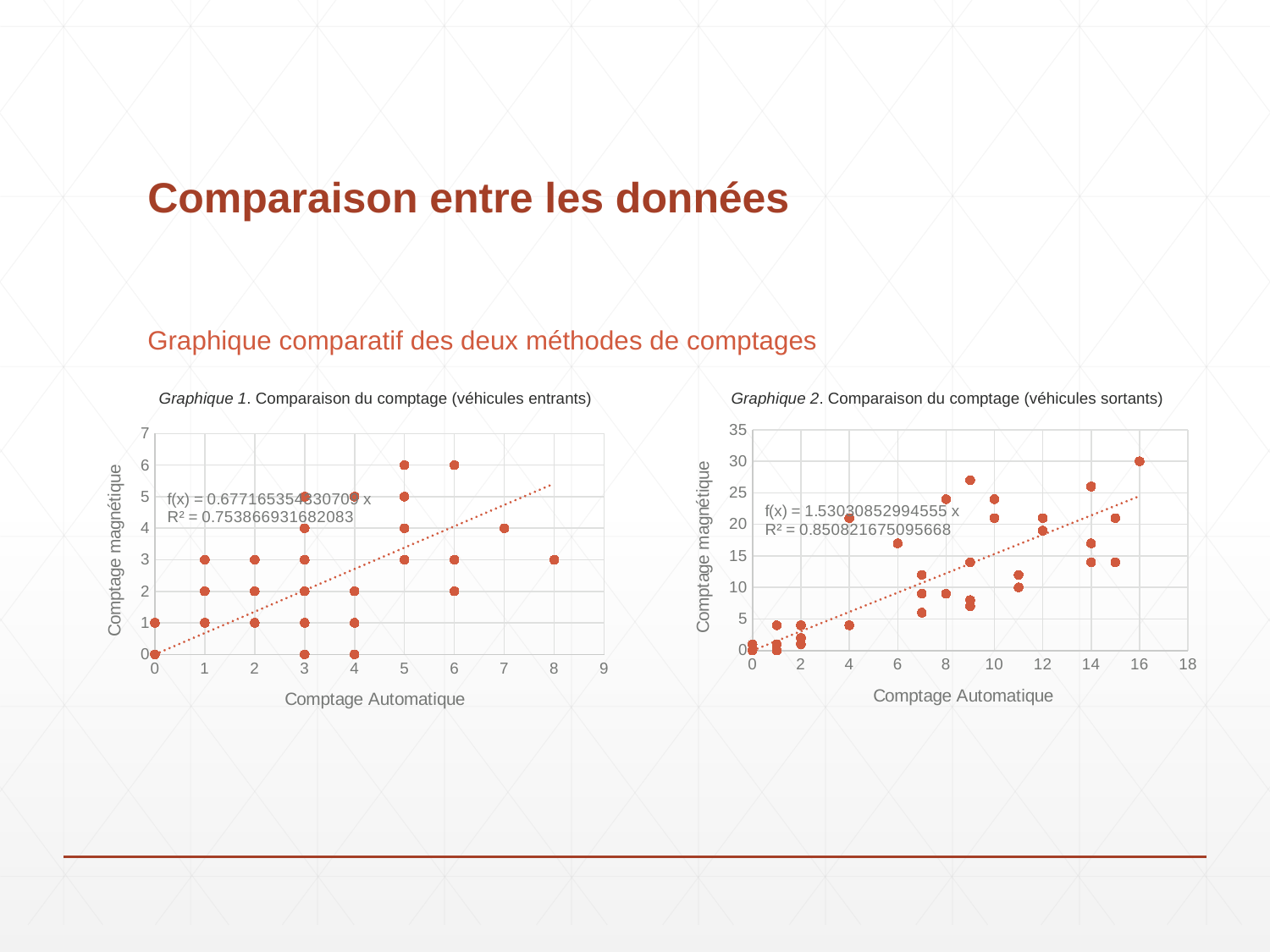
On Graphique 2 (véhicules sortants), do the values generally rise or fall as Comptage Automatique increases? Rise What is the title of the y axis on Graphique 1 (véhicules entrants)? Comptage magnétique On Graphique 1 (véhicules entrants), what is the Comptage magnétique value of the point plotted at Comptage Automatique 7? 4 On Graphique 1 (véhicules entrants), what is the largest Comptage Automatique value at which a point is plotted? 8 On Graphique 2 (véhicules sortants), is the Comptage magnétique value of the point at Comptage Automatique 16 greater or less than 25? greater On Graphique 2 (véhicules sortants), what is the highest Comptage magnétique value plotted? 30 On Graphique 1 (véhicules entrants), what is the Comptage magnétique value of the point plotted at Comptage Automatique 8? 3 On Graphique 1 (véhicules entrants), do the values generally rise or fall as Comptage Automatique increases? Rise What is the title of the x axis on Graphique 2 (véhicules sortants)? Comptage Automatique On Graphique 1 (véhicules entrants), what is the highest Comptage magnétique value plotted? 6 What kind of chart is Graphique 1 (véhicules entrants)? Scatter chart